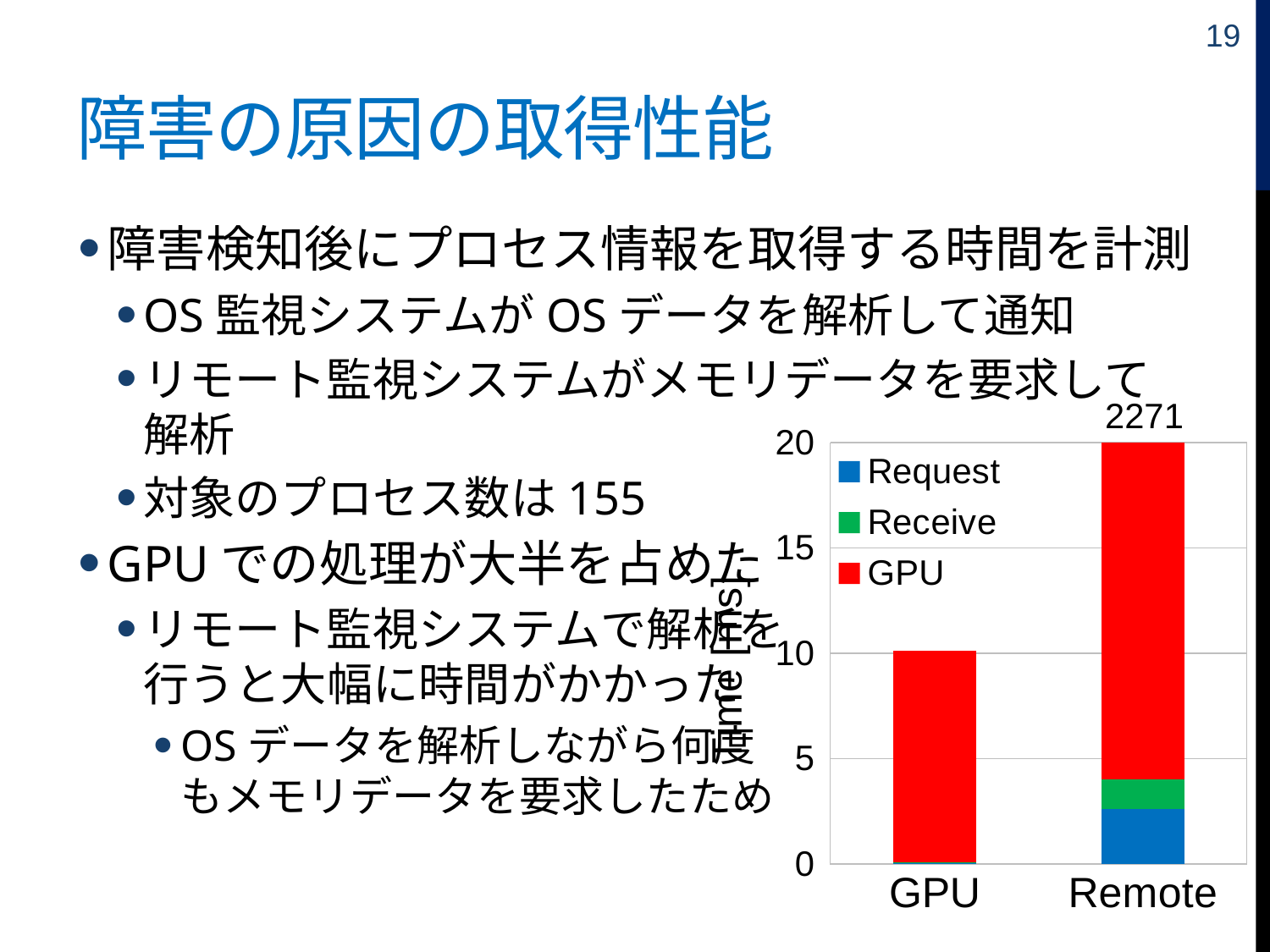
Is the total for the GPU bar greater or less than 15? less Which bar is taller, GPU or Remote? Remote Which category has the highest total in the chart? Remote What are the series names listed in the chart's legend? Request, Receive, GPU How many categories are shown on the x axis of the chart? 2 What colour represents the GPU series in the chart? red Is the Request portion of the Remote bar greater or less than 5? less Which category has the lowest total in the chart? GPU What kind of chart is shown on the slide? bar chart How many series does the chart's legend list? 3 Is the total for the GPU bar greater or less than 5? greater What value is printed above the Remote bar? 2271